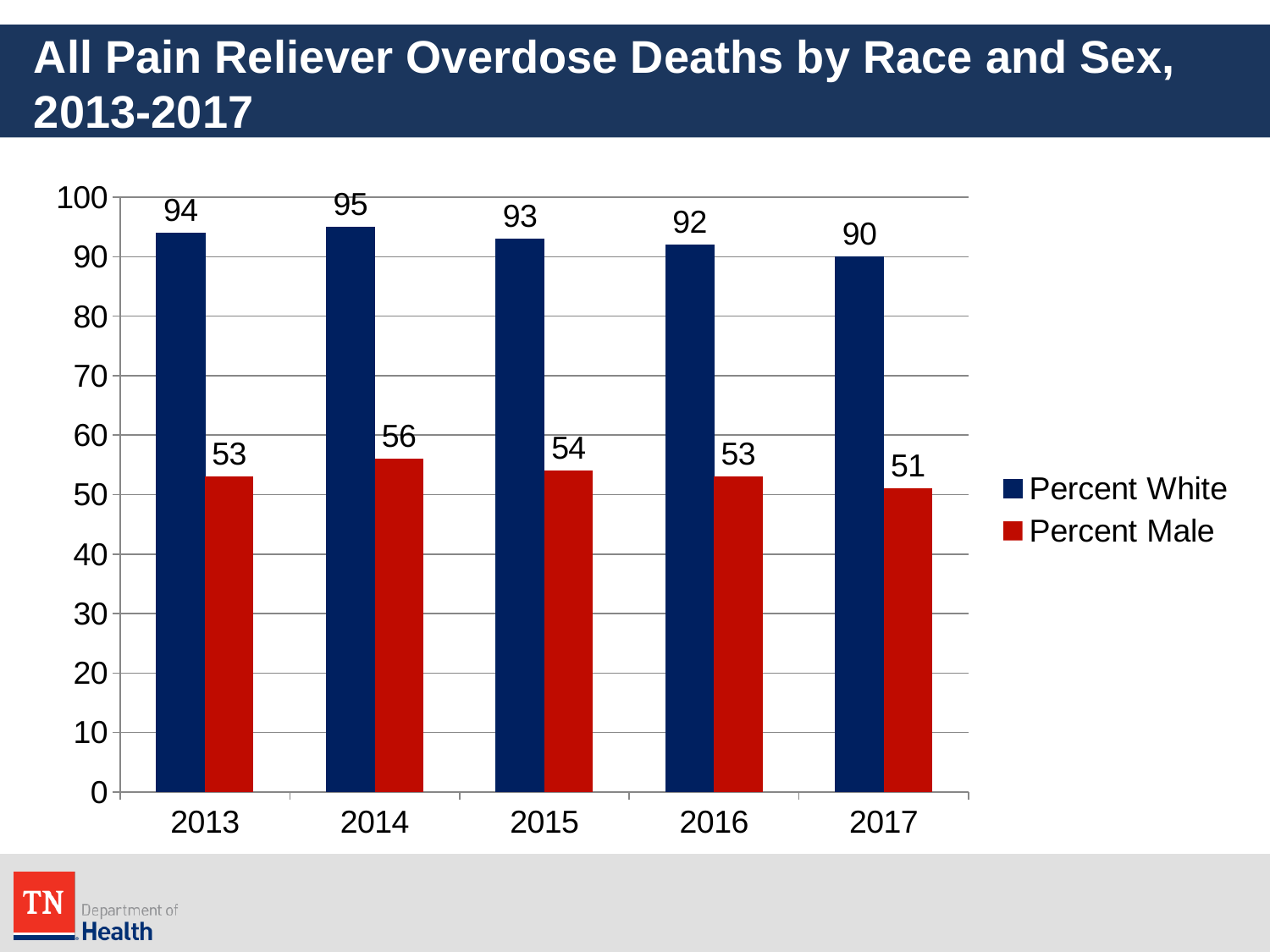
How many series does the legend list? 2 By how much did the Percent White value fall from 2014 to 2017? 5 Which year has the lowest Percent Male value? 2017 What kind of chart is shown on the slide? Bar chart What is the difference between the Percent White and Percent Male values in 2013? 41 How many years are shown on the x axis? 5 What is the Percent Male value for 2017? 51 Does the Percent White value rise or fall from 2014 to 2017? Fall What is the Percent White value for 2014? 95 Which is larger, the Percent Male value for 2014 or for 2016? 2014 Which year has the highest Percent White value? 2014 What is the Percent Male value for 2015? 54